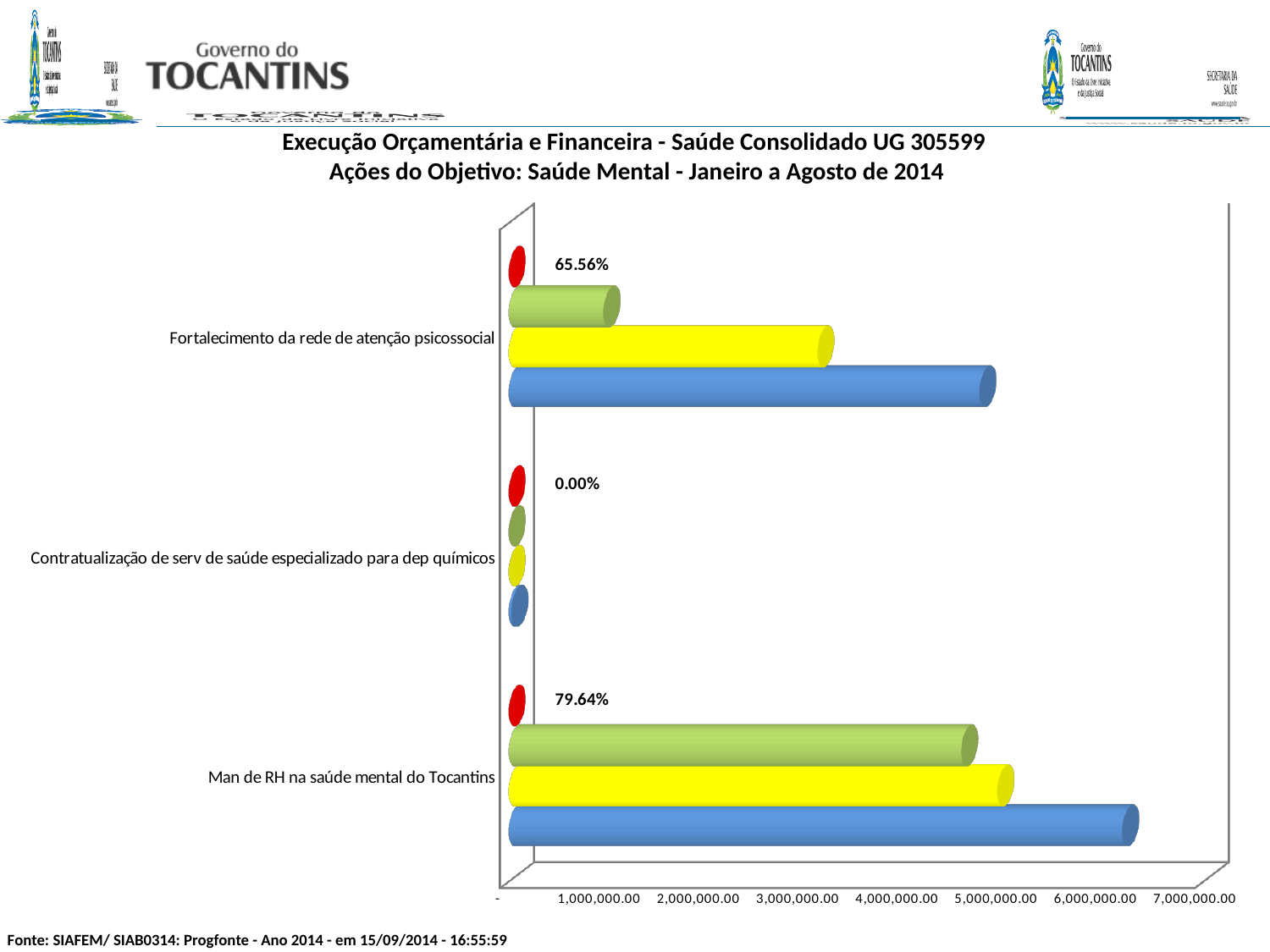
What percentage label is shown for "Contratualização de serv de saúde especializado para dep químicos"? 0.00% How many categories are shown on the chart? 3 Which category has the highest percentage label? Man de RH na saúde mental do Tocantins What is the difference between the percentage labels for "Man de RH na saúde mental do Tocantins" and "Fortalecimento da rede de atenção psicossocial"? 14.08% What percentage label is shown for "Man de RH na saúde mental do Tocantins"? 79.64% What kind of chart is shown on the slide? Bar chart Is the value of the green bar for "Man de RH na saúde mental do Tocantins" greater or less than 4,000,000.00? greater Which has the larger percentage label: "Fortalecimento da rede de atenção psicossocial" or "Man de RH na saúde mental do Tocantins"? Man de RH na saúde mental do Tocantins Is the value of the blue bar for "Man de RH na saúde mental do Tocantins" greater or less than 6,000,000.00? greater Which category has the lowest percentage label? Contratualização de serv de saúde especializado para dep químicos What percentage label is shown for "Fortalecimento da rede de atenção psicossocial"? 65.56%